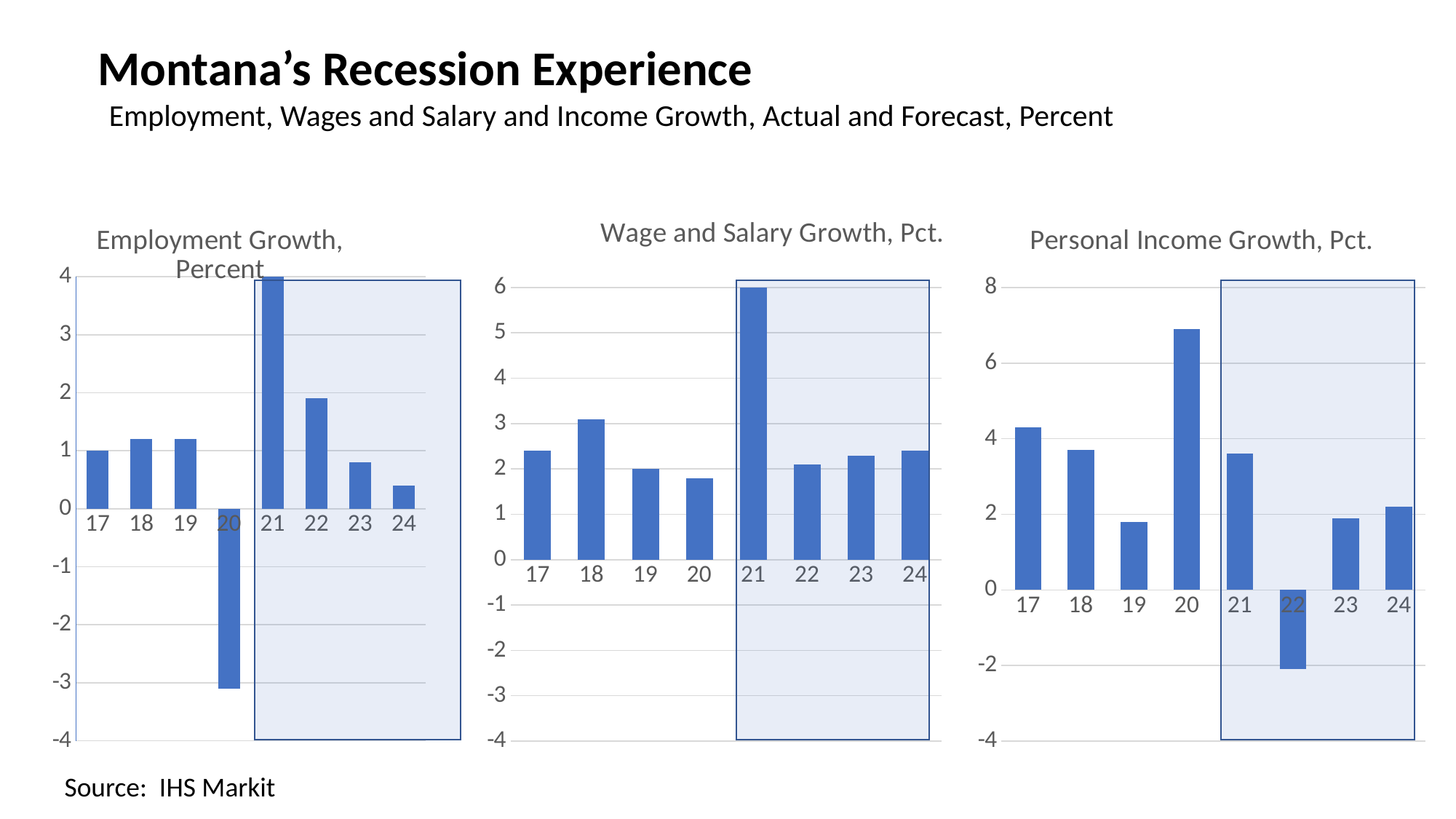
On the Wage and Salary Growth, Pct. chart, what is the value for 21? 6 On the Wage and Salary Growth, Pct. chart, which year has the lowest value? 20 On the Employment Growth, Percent chart, which year has the highest value? 21 On the Personal Income Growth, Pct. chart, which year has the lowest value? 22 On the Personal Income Growth, Pct. chart, which year has the highest value? 20 On the Personal Income Growth, Pct. chart, which is larger, the value for 17 or the value for 19? 17 On the Wage and Salary Growth, Pct. chart, what is the value for 19? 2 How many years are plotted on the Wage and Salary Growth, Pct. chart? 8 On the Employment Growth, Percent chart, which year has the lowest value? 20 On the Personal Income Growth, Pct. chart, is the value for 20 greater or less than 6? greater On the Employment Growth, Percent chart, what is the value for 21? 4 What kind of chart is the Employment Growth, Percent chart? bar chart